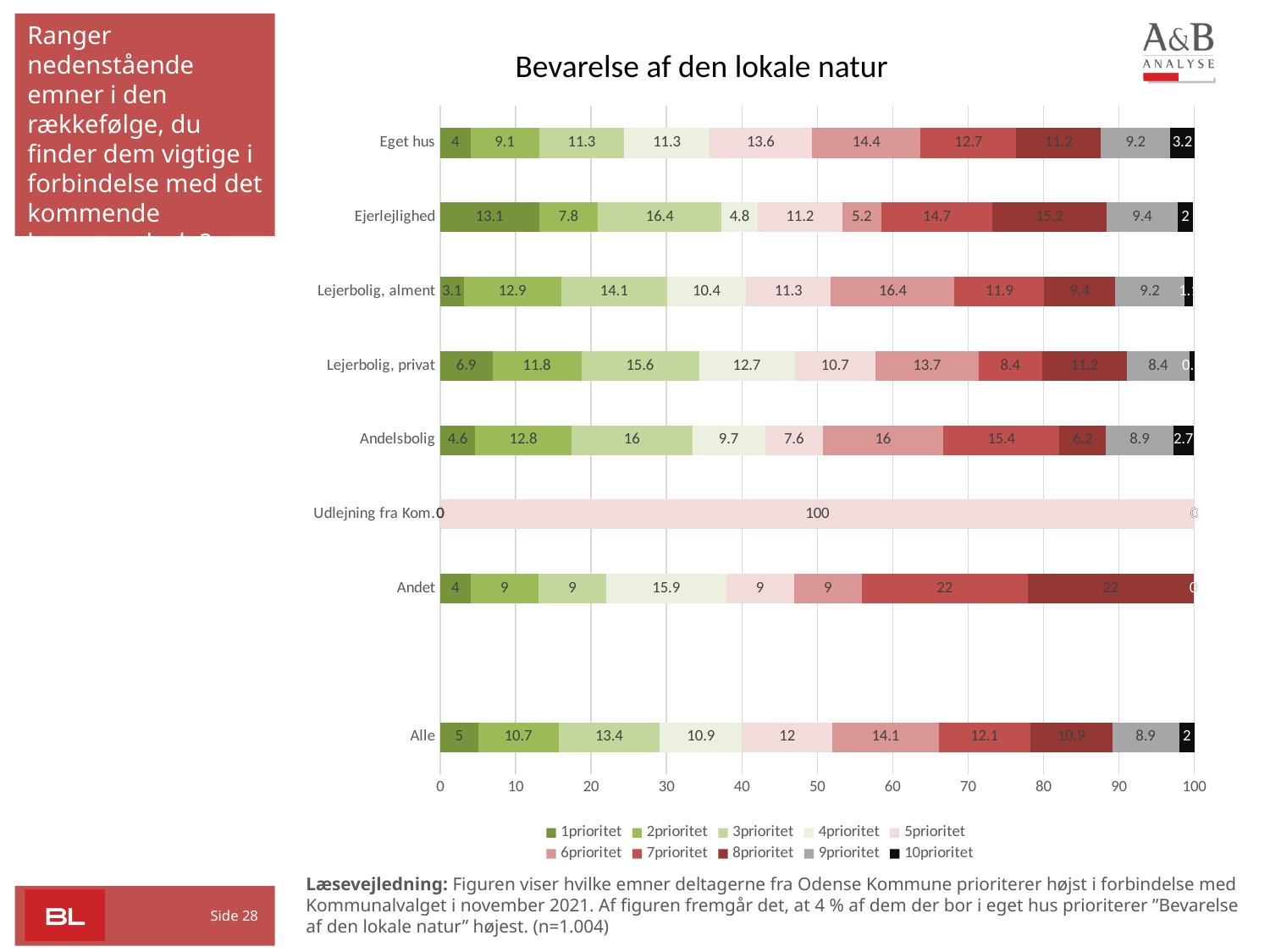
What is the value of 5prioritet for Udlejning fra Kom.? 100 How many series does the legend list? 10 What kind of chart is shown on the slide? Stacked bar chart What is the value of 1prioritet for Eget hus? 4 What is the value of 3prioritet for Ejerlejlighed? 16.4 Which category has the lowest value for 1prioritet? Udlejning fra Kom. What is the title of the chart? Bevarelse af den lokale natur Which is larger, the 2prioritet value for Lejerbolig, alment or for Eget hus? Lejerbolig, alment What is the value of 6prioritet for Alle? 14.1 What is the difference between the 1prioritet values for Ejerlejlighed and Eget hus? 9.1 How many categories are shown on the y axis? 8 Which category has the highest value for 1prioritet? Ejerlejlighed